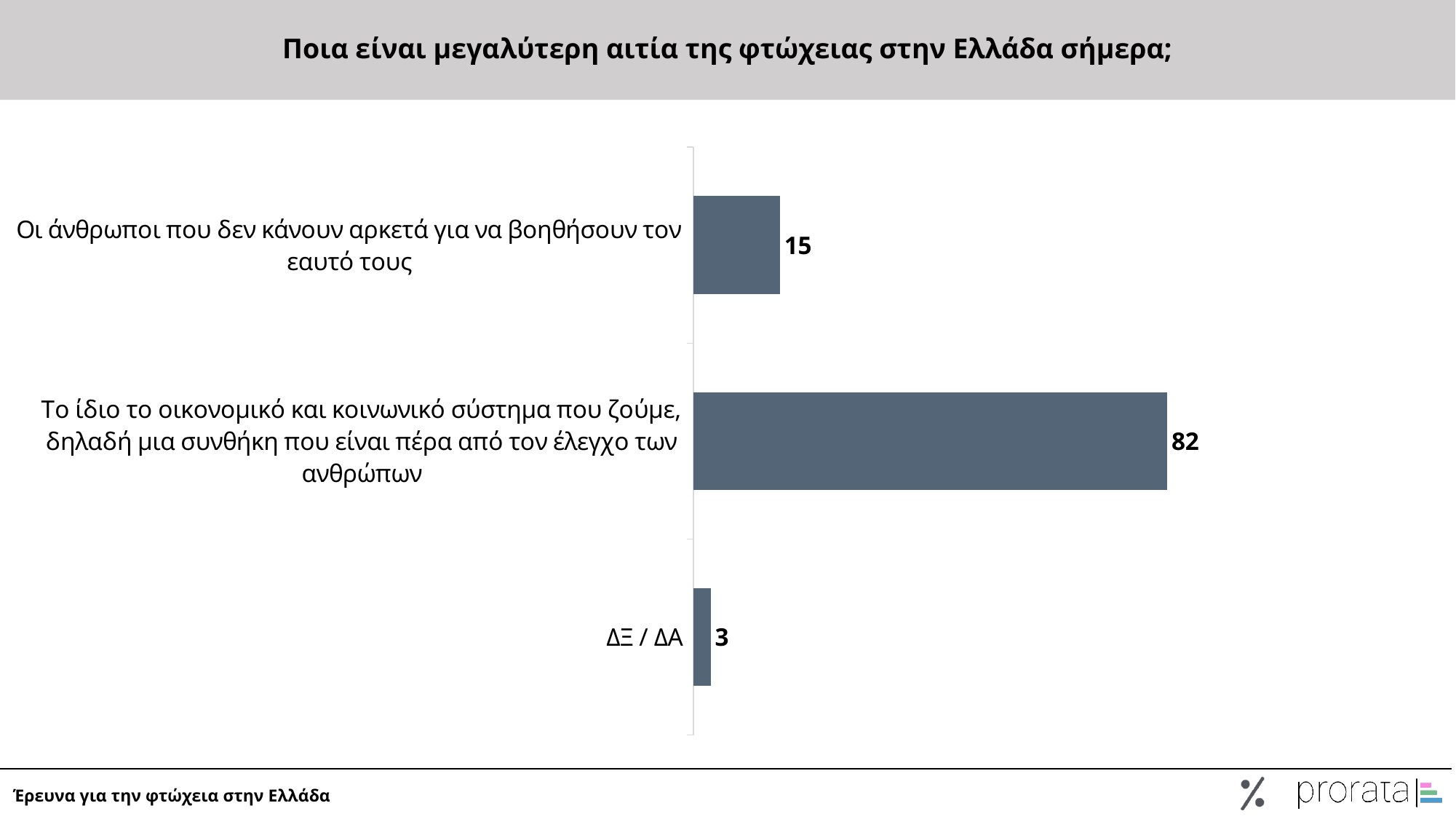
What is the value for "Οι άνθρωποι που δεν κάνουν αρκετά για να βοηθήσουν τον εαυτό τους"? 15 What is the difference between the value for "Το ίδιο το οικονομικό και κοινωνικό σύστημα..." and the value for "Οι άνθρωποι που δεν κάνουν αρκετά..."? 67 How many categories are shown in the chart? 3 Which is larger: the value for "Οι άνθρωποι που δεν κάνουν αρκετά..." or the value for "ΔΞ / ΔΑ"? Οι άνθρωποι που δεν κάνουν αρκετά για να βοηθήσουν τον εαυτό τους What is the value for "ΔΞ / ΔΑ"? 3 What is the title of the chart? Ποια είναι μεγαλύτερη αιτία της φτώχειας στην Ελλάδα σήμερα; What is the value for "Το ίδιο το οικονομικό και κοινωνικό σύστημα που ζούμε, δηλαδή μια συνθήκη που είναι πέρα από τον έλεγχο των ανθρώπων"? 82 What is the difference between the value for "Οι άνθρωποι που δεν κάνουν αρκετά..." and the value for "ΔΞ / ΔΑ"? 12 What is the total of the three values shown in the chart? 100 Which category has the highest value? Το ίδιο το οικονομικό και κοινωνικό σύστημα που ζούμε, δηλαδή μια συνθήκη που είναι πέρα από τον έλεγχο των ανθρώπων What kind of chart is shown on the slide? Bar chart Which category has the lowest value? ΔΞ / ΔΑ